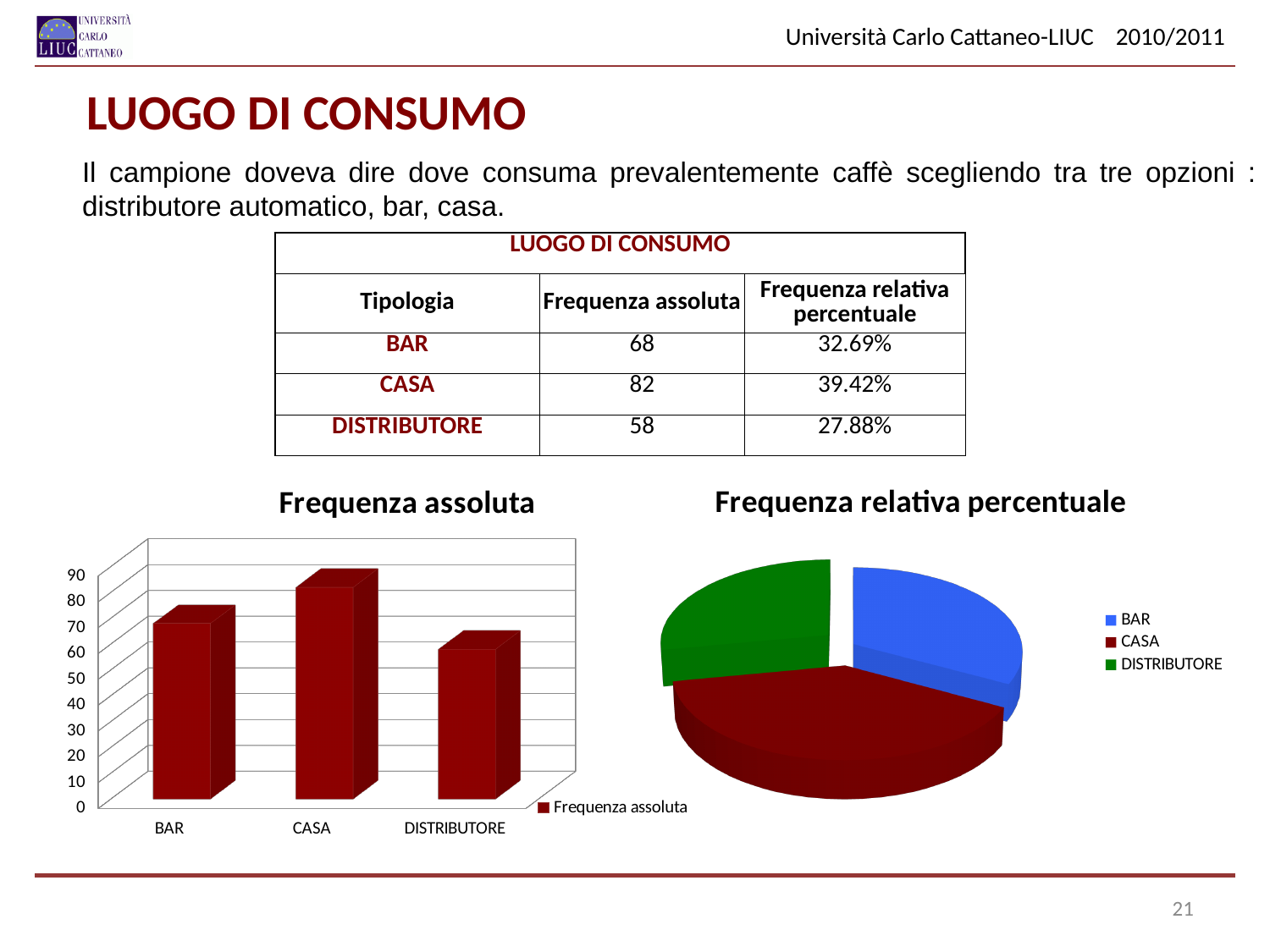
In the "Frequenza assoluta" bar chart, which category has the lowest bar? DISTRIBUTORE What kind of chart is the "Frequenza relativa percentuale" chart? pie chart What kind of chart is the "Frequenza assoluta" chart? bar chart In the "Frequenza assoluta" bar chart, is the bar for BAR taller than the bar for DISTRIBUTORE? yes In the "Frequenza assoluta" bar chart, which category has the highest bar? CASA How many entries does the legend of the "Frequenza relativa percentuale" pie chart list? 3 In the "Frequenza assoluta" bar chart, is the value for CASA greater or less than 80? greater What is the difference between the absolute frequencies of CASA and DISTRIBUTORE shown on the slide? 24 What is the absolute frequency (Frequenza assoluta) for BAR shown on the slide? 68 In the "Frequenza assoluta" bar chart, is the value for DISTRIBUTORE greater or less than 60? less How many categories are shown in the "Frequenza assoluta" bar chart? 3 In the "Frequenza relativa percentuale" pie chart, what share does the CASA slice represent according to the slide? 39.42%